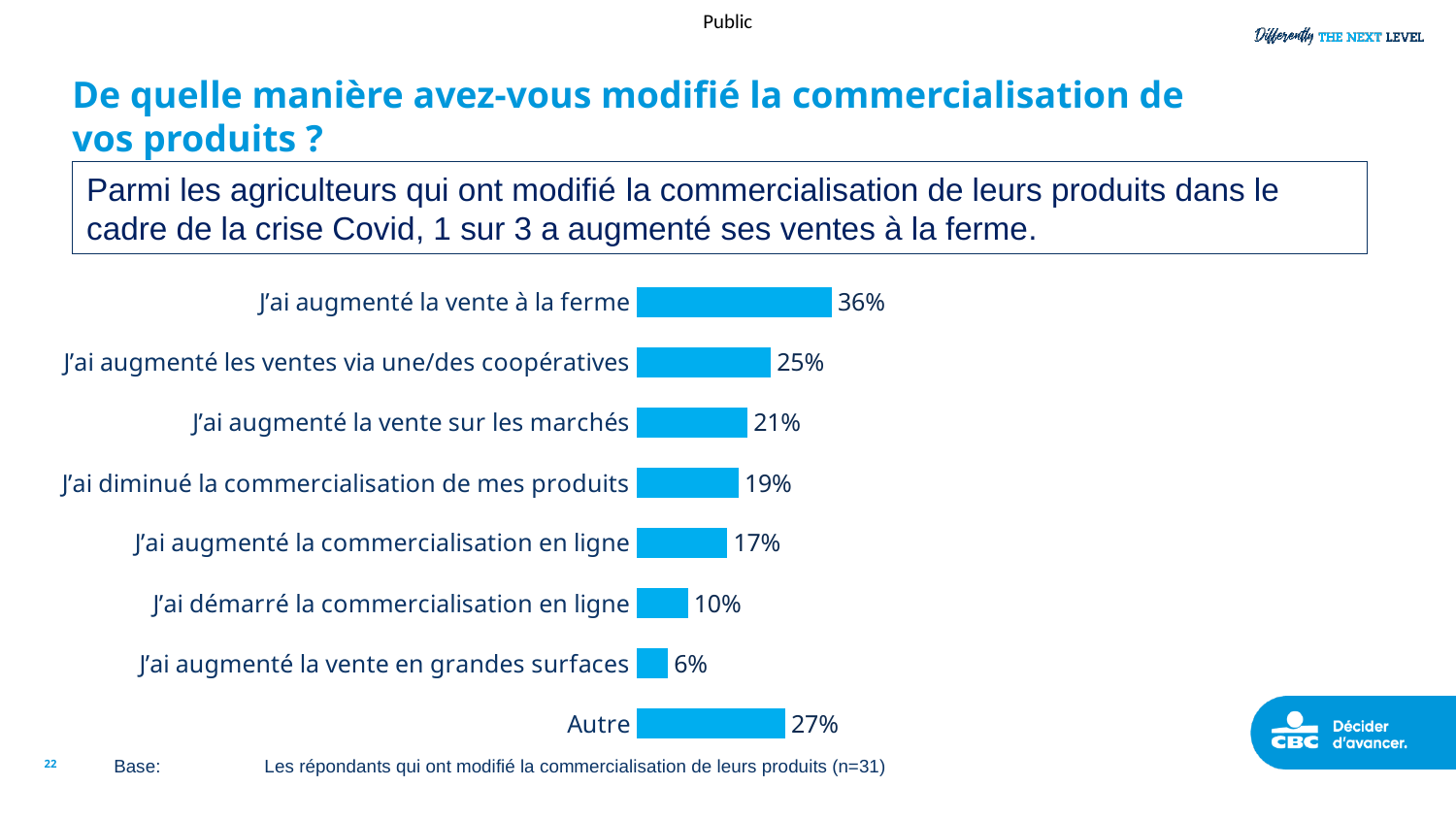
What is the sample size (n) given in the base note below the chart? n=31 Which category has the highest value? J'ai augmenté la vente à la ferme Which category has the lowest value? J'ai augmenté la vente en grandes surfaces Which is larger: "J'ai augmenté la vente sur les marchés" or "J'ai diminué la commercialisation de mes produits"? J'ai augmenté la vente sur les marchés What kind of chart is shown on the slide? Bar chart What is the value for "J'ai augmenté la commercialisation en ligne"? 17% What is the value for "Autre"? 27% Which is larger: "Autre" or "J'ai augmenté les ventes via une/des coopératives"? Autre What is the value for "J'ai augmenté la vente à la ferme"? 36% What is the difference between "J'ai démarré la commercialisation en ligne" and "J'ai augmenté la vente en grandes surfaces"? 4% What is the difference between "J'ai augmenté la vente à la ferme" and "J'ai augmenté les ventes via une/des coopératives"? 11% How many categories are shown in the chart? 8